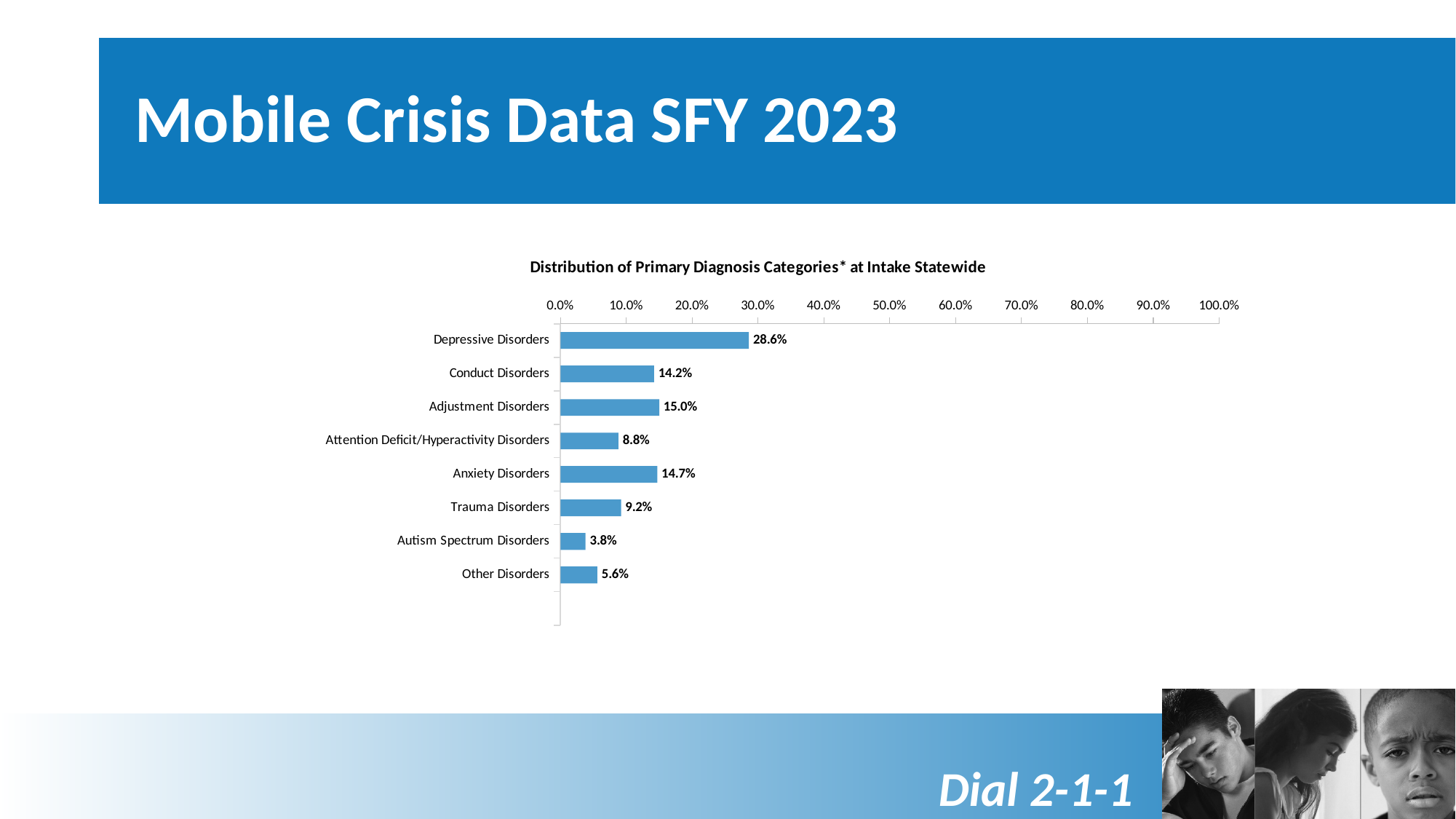
What is the value for Attention Deficit/Hyperactivity Disorders? 8.8% What is the value for Depressive Disorders? 28.6% What is the title of the chart? Distribution of Primary Diagnosis Categories* at Intake Statewide What is the difference between the values for Trauma Disorders and Other Disorders? 3.6% What is the value for Autism Spectrum Disorders? 3.8% Which diagnosis category has the lowest value? Autism Spectrum Disorders Which diagnosis category has the highest value? Depressive Disorders How many diagnosis categories are shown in the chart? 8 Is the value for Depressive Disorders greater or less than 20.0%? greater Which is larger, the value for Anxiety Disorders or the value for Trauma Disorders? Anxiety Disorders What is the difference between the values for Depressive Disorders and Adjustment Disorders? 13.6% What kind of chart is shown on the slide? Bar chart